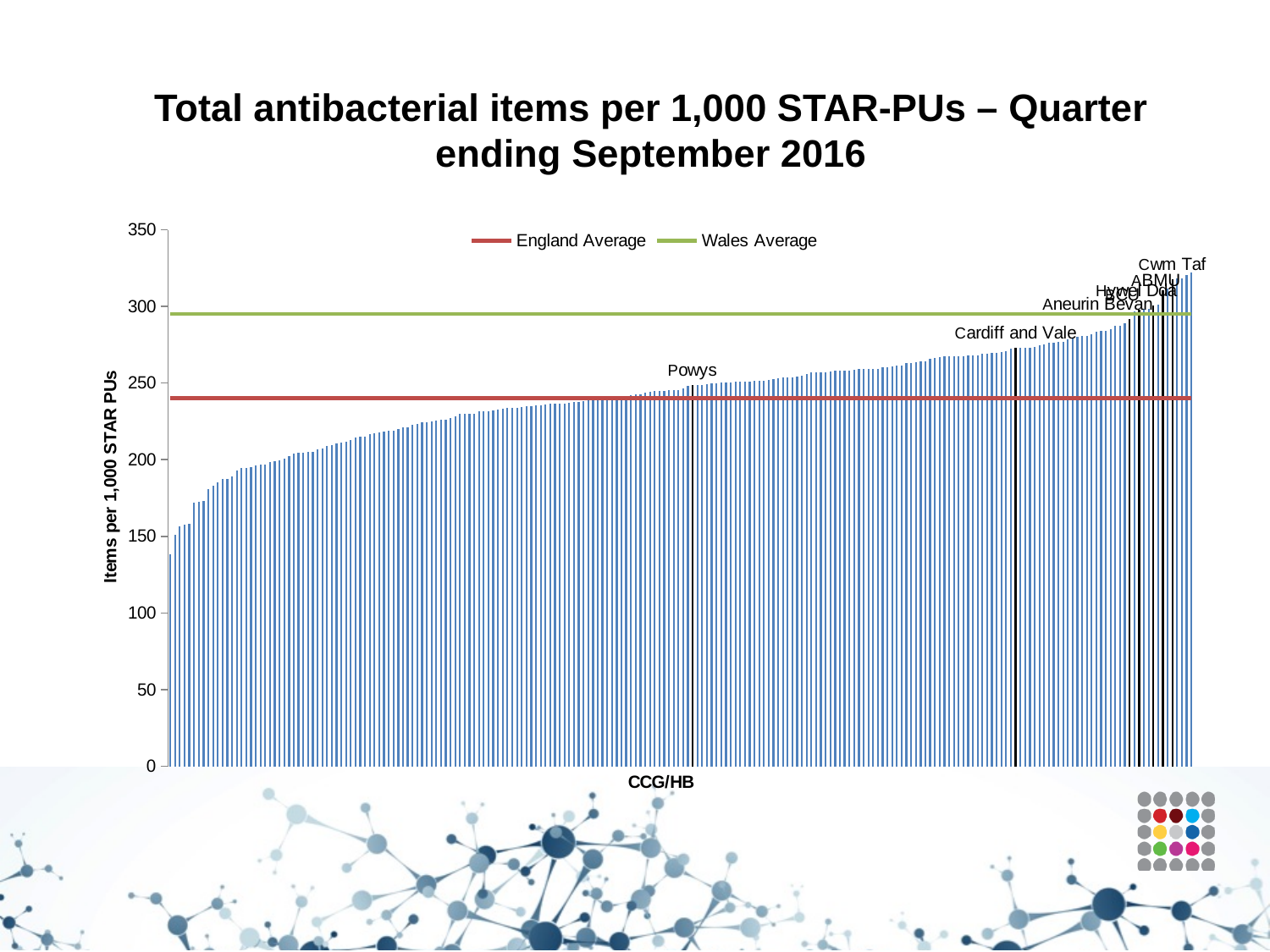
Which has the larger value, Cwm Taf or Powys? Cwm Taf Is the value for Powys greater or less than 200? greater What kind of chart is shown on the slide? bar chart Is the value for Aneurin Bevan greater or less than 250? greater Of the labelled health boards, which has the lowest value? Powys Is the England Average line greater or less than 250? less Do the bar values rise or fall moving from left to right along the x axis? rise Of the labelled health boards, which has the highest value? Cwm Taf What is the title of the y axis? Items per 1,000 STAR PUs How many entries does the chart legend list? 2